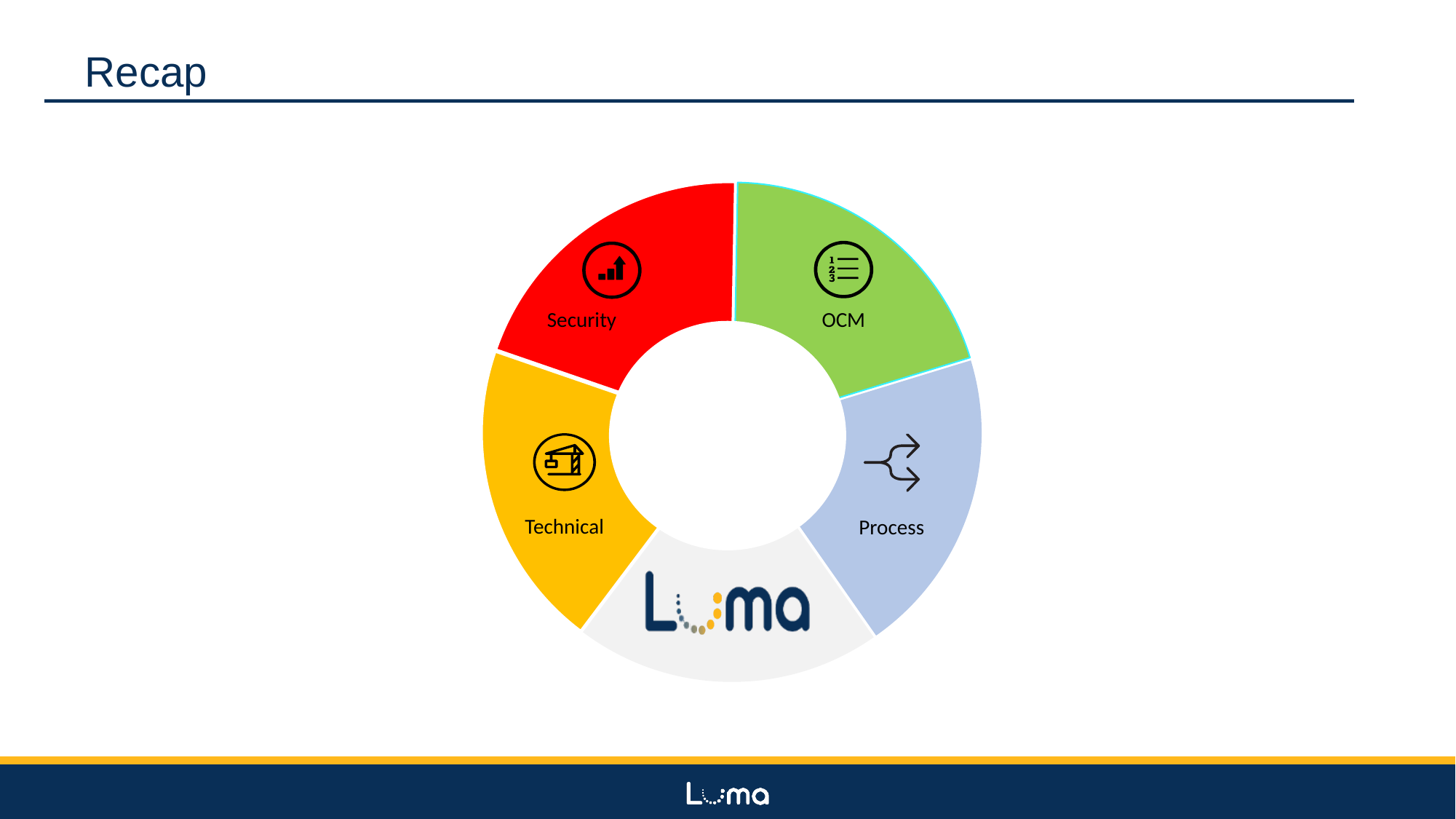
Which segment of the doughnut chart is light blue? Process How many segments does the doughnut chart have? 5 What colour is the segment labelled Technical? yellow What is the title of the slide containing the doughnut chart? Recap What kind of chart is shown on the slide? doughnut chart What is the label of the red segment of the doughnut chart? Security Which segment of the doughnut chart is green? OCM Which segment of the doughnut chart contains the Luma logo instead of a text label? the grey segment at the bottom